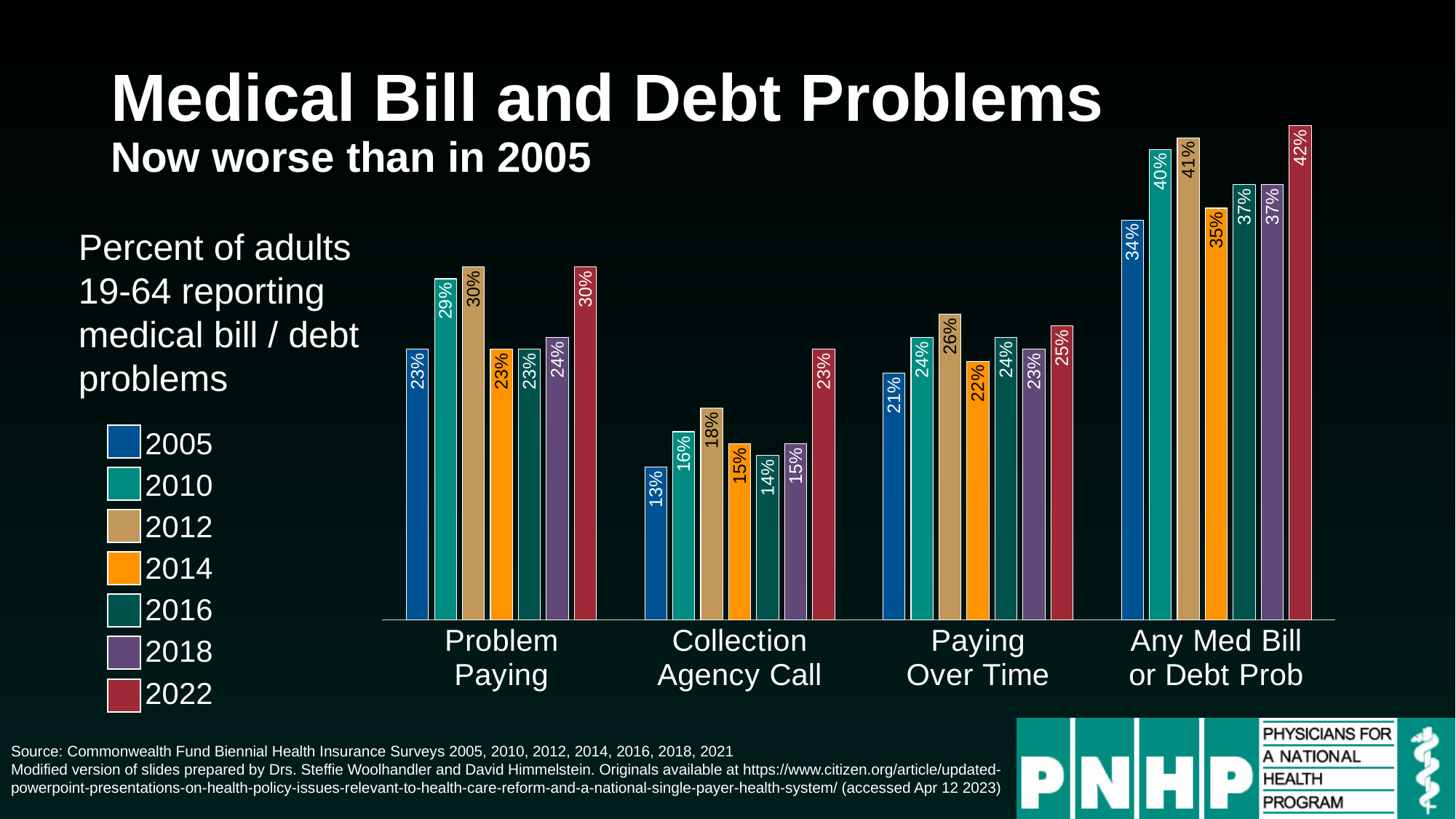
What is the value for Collection Agency Call in 2022? 23% What is the value for Paying Over Time in 2022? 25% How many series does the legend list? 7 What kind of chart is shown on the slide? bar chart Which year has the lowest value for Collection Agency Call? 2005 What is the difference between the 2022 and 2005 values for Any Med Bill or Debt Prob? 8% What percentage of adults reported a Problem Paying in 2005? 23% How many categories are shown on the x axis? 4 Which year has the highest value for Any Med Bill or Debt Prob? 2022 What is the value for Any Med Bill or Debt Prob in 2012? 41% Which is larger for Paying Over Time: the 2012 value or the 2014 value? 2012 What is the subtitle of the chart slide? Now worse than in 2005